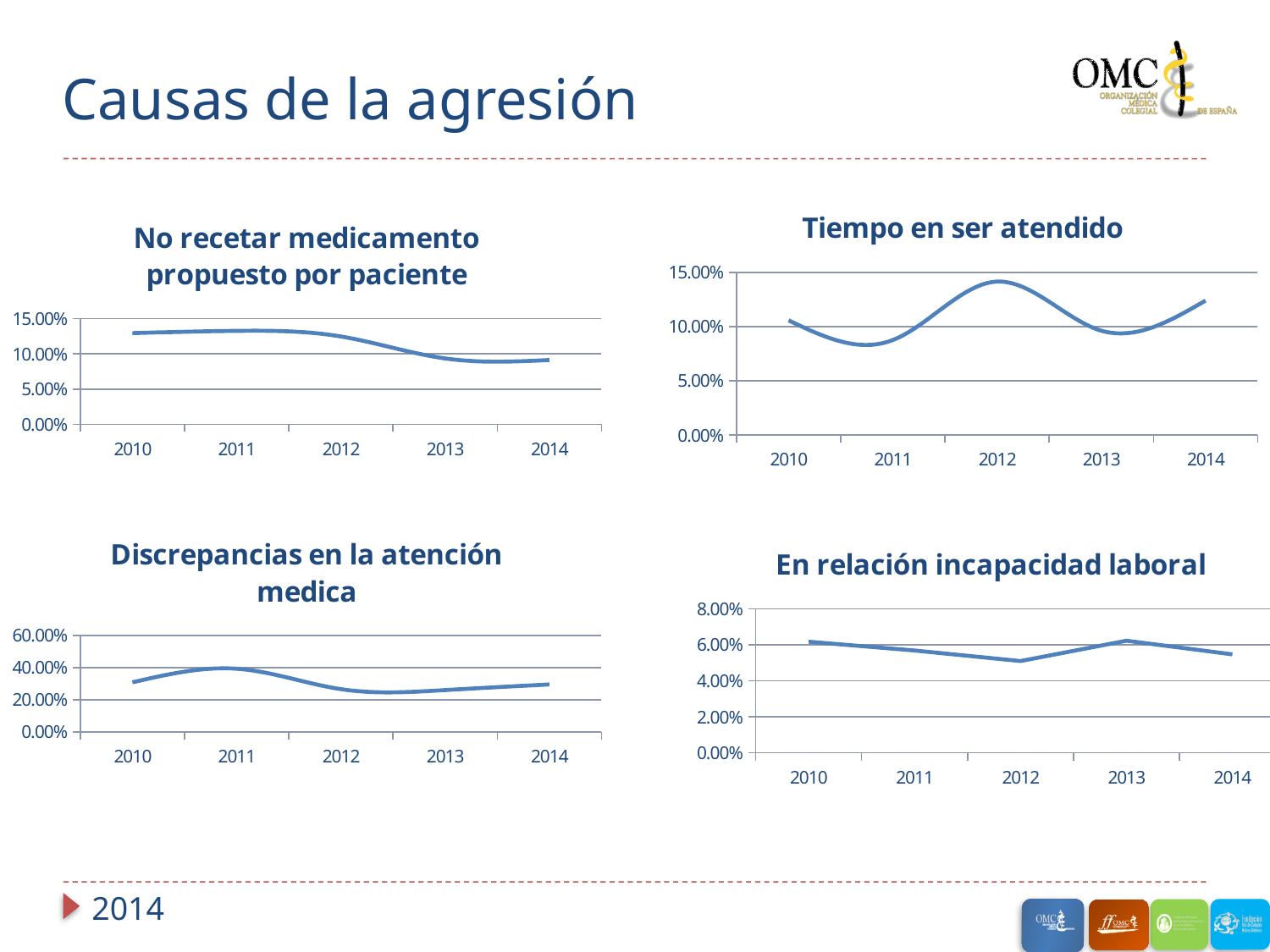
In the "En relación incapacidad laboral" chart, is the value for 2010 greater or less than 4.00%? greater In the "Discrepancias en la atención medica" chart, which year has the highest value? 2011 In the "No recetar medicamento propuesto por paciente" chart, how many years are plotted on the x axis? 5 In the "Discrepancias en la atención medica" chart, which is larger, the value for 2011 or the value for 2012? 2011 In the "No recetar medicamento propuesto por paciente" chart, is the value for 2013 greater or less than 10.00%? less What kind of chart is "Tiempo en ser atendido"? line chart In the "Tiempo en ser atendido" chart, which year has the highest value? 2012 In the "Tiempo en ser atendido" chart, which year has the lowest value? 2011 In the "No recetar medicamento propuesto por paciente" chart, do the values overall rise or fall from 2010 to 2014? fall How many charts are shown on the slide? 4 In the "En relación incapacidad laboral" chart, which year has the lowest value? 2012 In the "Tiempo en ser atendido" chart, is the value for 2011 greater or less than 10.00%? less